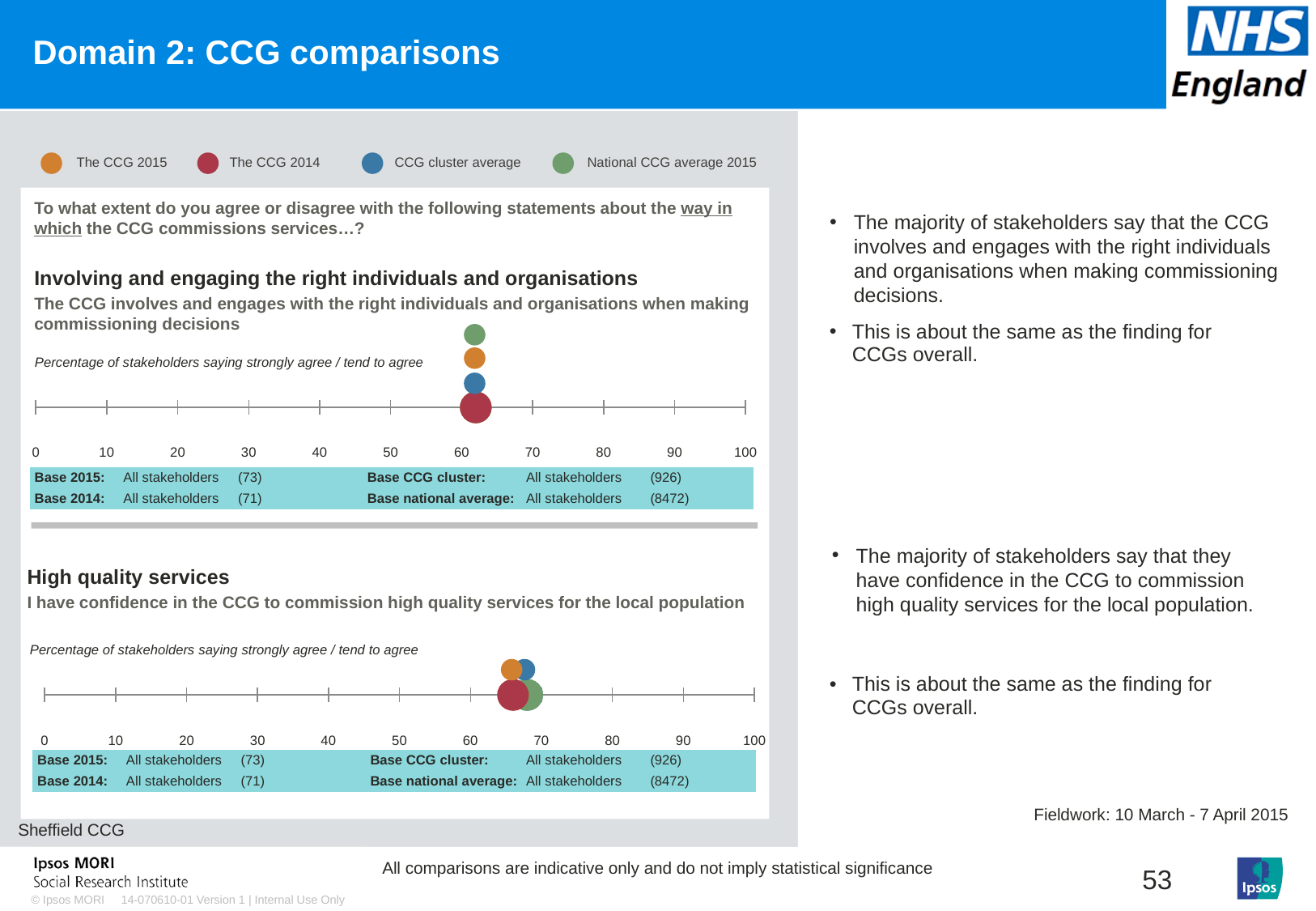
How many charts are shown on the slide? 2 In the 'High quality services' chart, is the value for the CCG cluster average greater or less than 80? less In the 'High quality services' chart, is the value for The CCG 2015 greater or less than 60? greater What are the four series named in the legend? The CCG 2015, The CCG 2014, CCG cluster average, National CCG average 2015 In the 'Involving and engaging the right individuals and organisations' chart, is the value for The CCG 2014 greater or less than 70? less What is the maximum value shown on the x axis of the 'High quality services' chart? 100 How many series does the legend at the top of the slide list? 4 Which colour represents 'The CCG 2015' in the legend? Orange What kind of chart is used for the 'Involving and engaging the right individuals and organisations' comparison? Dot plot